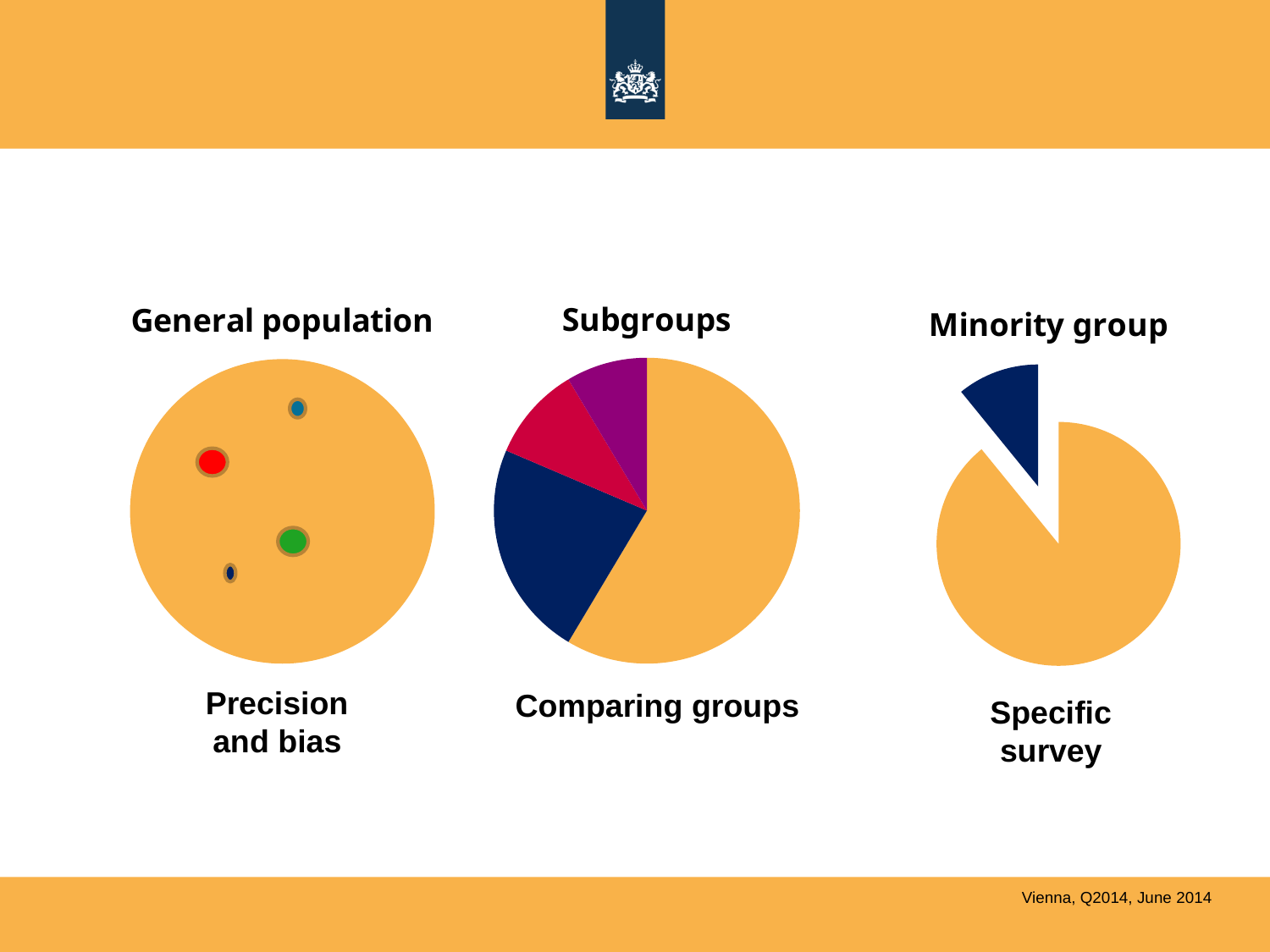
In the "Minority group" pie chart, which slice is pulled out from the rest of the pie? the dark blue slice In the "Subgroups" pie chart, how many slices are there? 4 What caption appears below the "Subgroups" pie chart? Comparing groups What kind of chart is shown under the heading "Minority group"? pie chart In the "Minority group" pie chart, how many slices are there? 2 In the "Subgroups" pie chart, which is larger, the orange slice or the dark blue slice? the orange slice In the "Minority group" pie chart, which colour slice is the smallest? dark blue What kind of chart is shown under the heading "Subgroups"? pie chart In the "Subgroups" pie chart, which colour slice is the largest? orange In the "Subgroups" pie chart, which is larger, the dark blue slice or the red slice? the dark blue slice